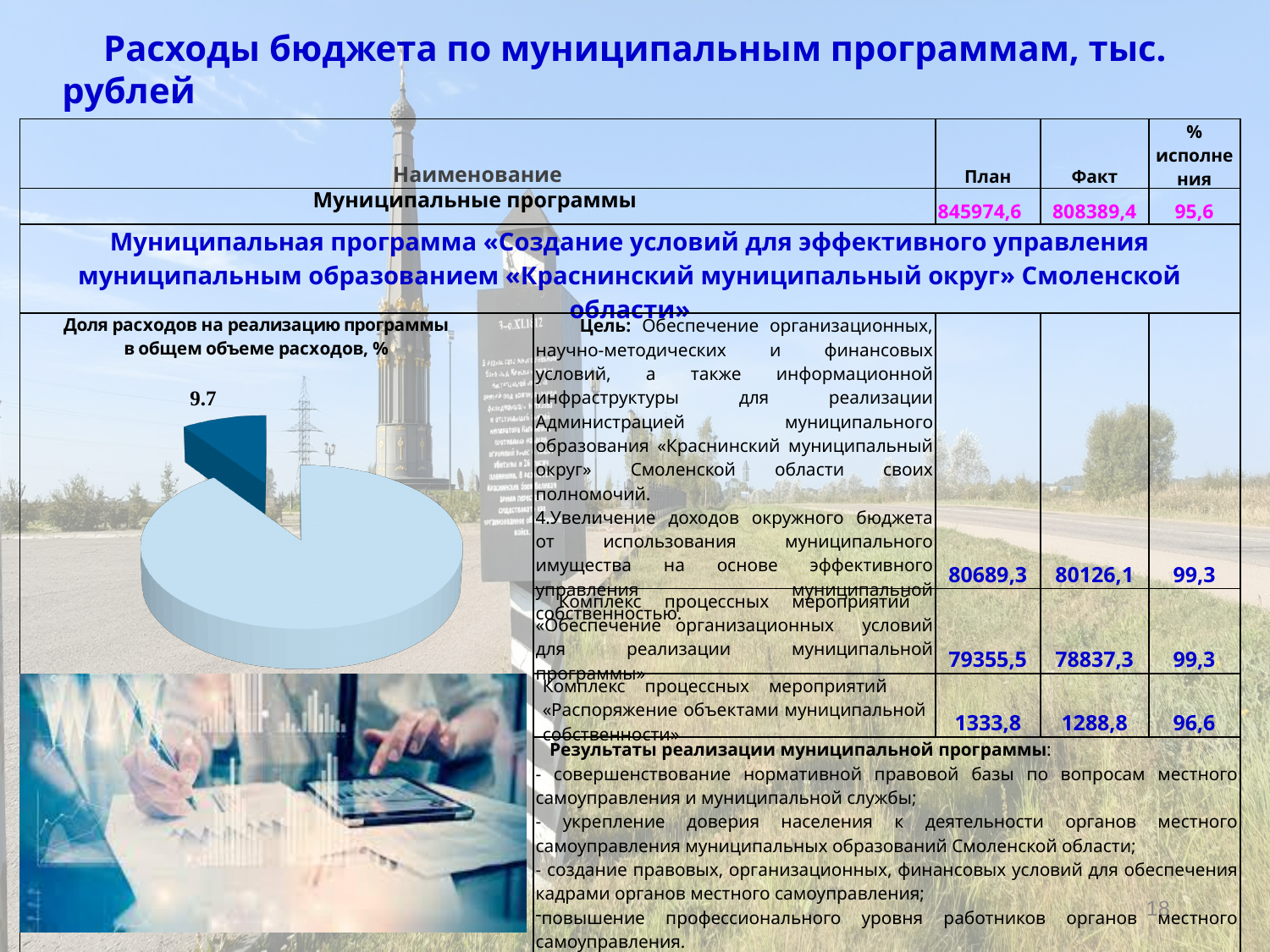
Is the dark blue slice in the pie chart pulled out (exploded) from the rest of the pie? yes What share of total expenditures does the pie chart show for the programme? 9.7% Which slice of the pie chart is larger, the dark blue one or the light blue one? the light blue one Is the value of the dark blue slice in the pie chart greater or less than 10? less What kind of chart is shown on the slide? pie chart What is the title of the pie chart? Доля расходов на реализацию программы в общем объеме расходов, % How many slices does the pie chart have? 2 What value is printed on the dark blue slice of the pie chart? 9.7 Which slice of the pie chart is the smallest? the dark blue slice (9.7)